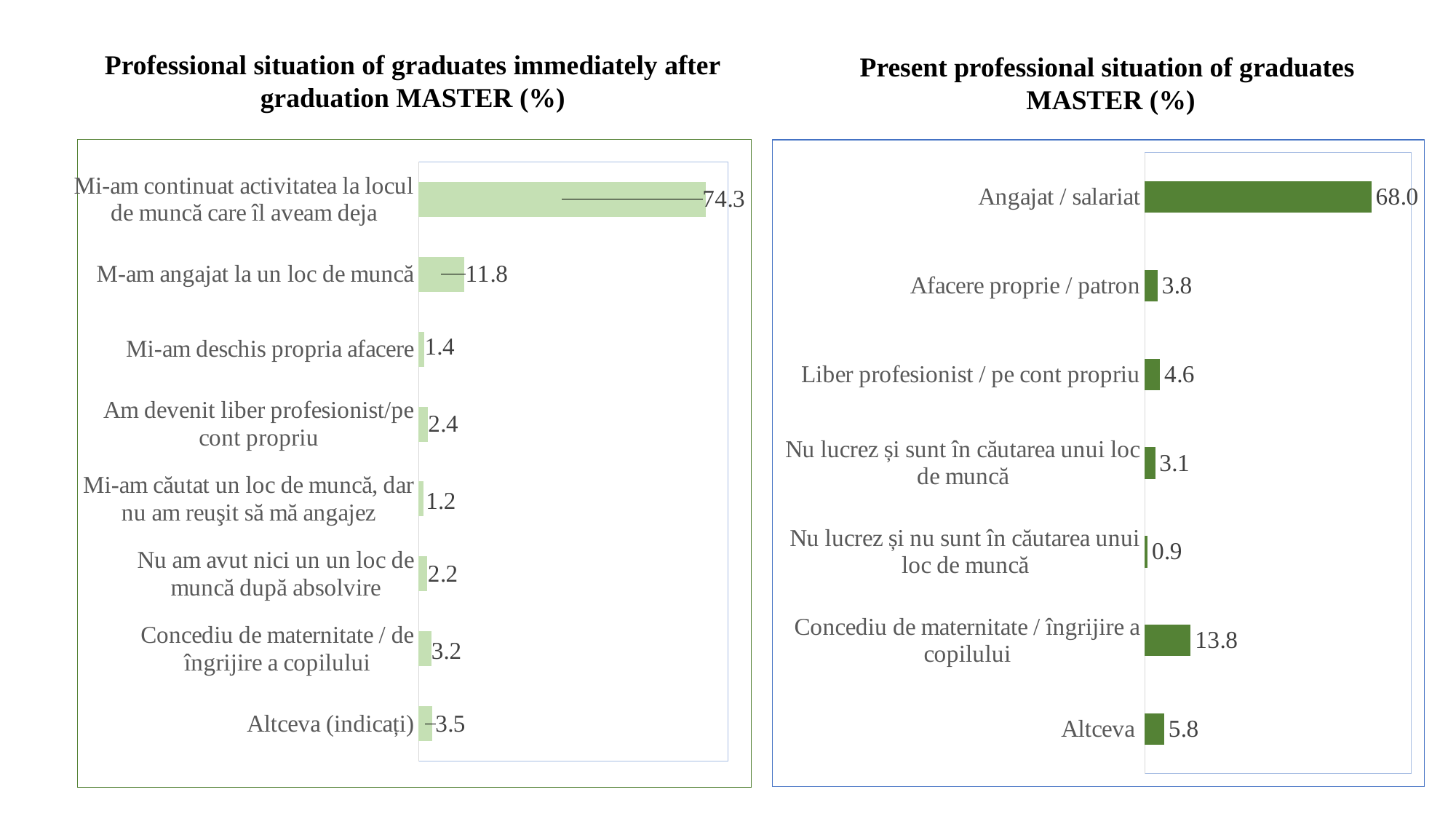
In the chart 'Professional situation of graduates immediately after graduation MASTER (%)', what is the value for 'M-am angajat la un loc de muncă'? 11.8 In the chart 'Present professional situation of graduates MASTER (%)', how many categories are shown? 7 In the chart 'Professional situation of graduates immediately after graduation MASTER (%)', which category has the lowest value? Mi-am căutat un loc de muncă, dar nu am reuşit să mă angajez In the chart 'Professional situation of graduates immediately after graduation MASTER (%)', which category has the highest value? Mi-am continuat activitatea la locul de muncă care îl aveam deja In the chart 'Present professional situation of graduates MASTER (%)', which category has the highest value? Angajat / salariat In the chart 'Present professional situation of graduates MASTER (%)', which category has the lowest value? Nu lucrez și nu sunt în căutarea unui loc de muncă In the chart 'Present professional situation of graduates MASTER (%)', what is the value for 'Concediu de maternitate / îngrijire a copilului'? 13.8 In the chart 'Present professional situation of graduates MASTER (%)', what is the difference between the values for 'Angajat / salariat' and 'Concediu de maternitate / îngrijire a copilului'? 54.2 What type of chart is the chart on the right side of the slide? Bar chart In the chart 'Professional situation of graduates immediately after graduation MASTER (%)', how many categories are shown? 8 In the chart 'Present professional situation of graduates MASTER (%)', which is larger: the value for 'Liber profesionist / pe cont propriu' or 'Afacere proprie / patron'? Liber profesionist / pe cont propriu In the chart 'Professional situation of graduates immediately after graduation MASTER (%)', what is the difference between the values for 'Altceva (indicați)' and 'Concediu de maternitate / de îngrijire a copilului'? 0.3